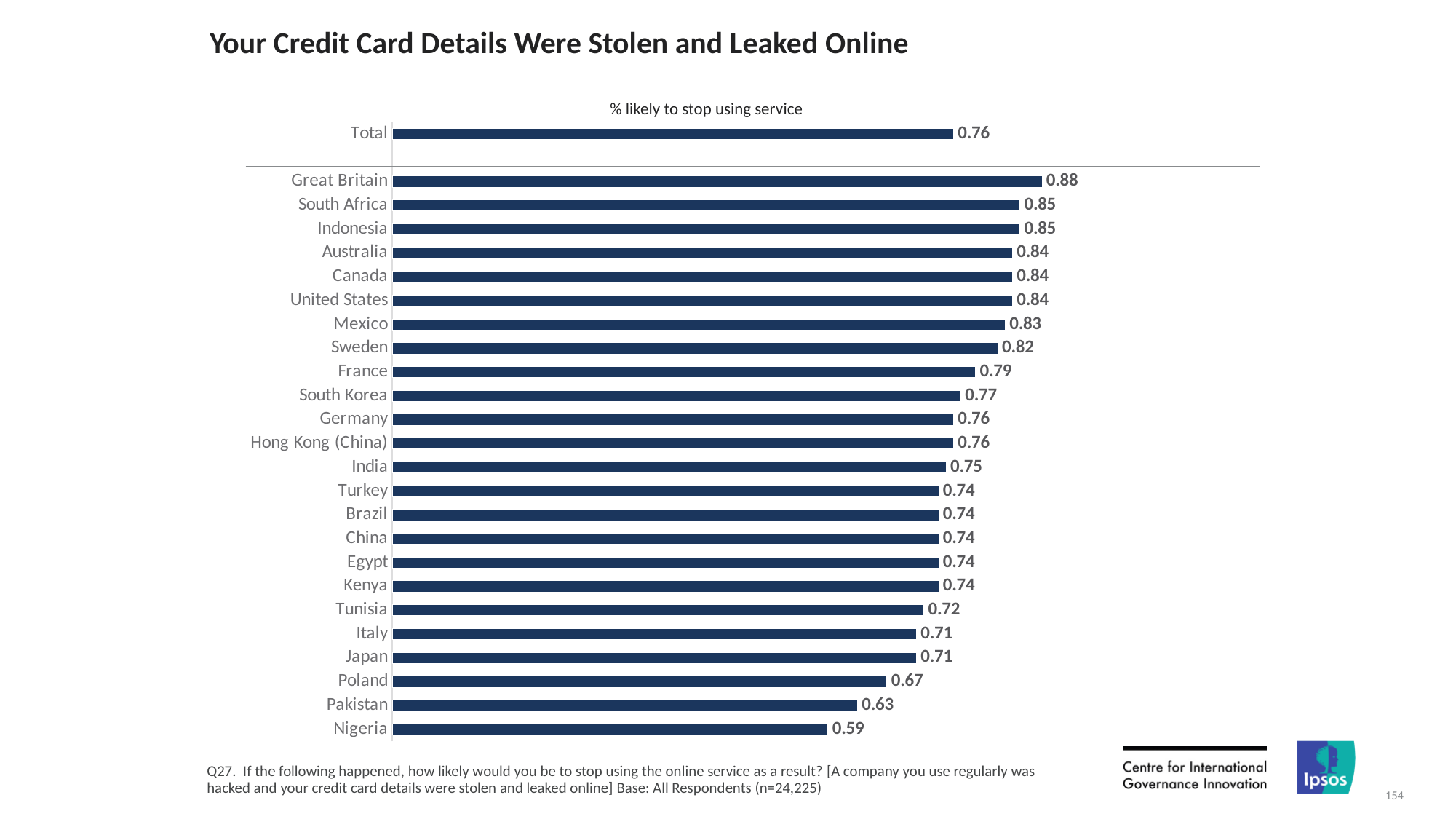
What is the value for Great Britain? 0.88 What is the difference between the values for Great Britain and Nigeria? 0.29 What is the value for the Total bar? 0.76 What is the subtitle shown above the chart bars? % likely to stop using service What kind of chart is shown on the slide? Bar chart How many country bars are shown below the Total bar? 24 Which country has the lowest value? Nigeria Which country has the highest value? Great Britain What is the difference between the values for Poland and Pakistan? 0.04 What is the value for Nigeria? 0.59 What is the value for Sweden? 0.82 Which has a larger value, Mexico or France? Mexico